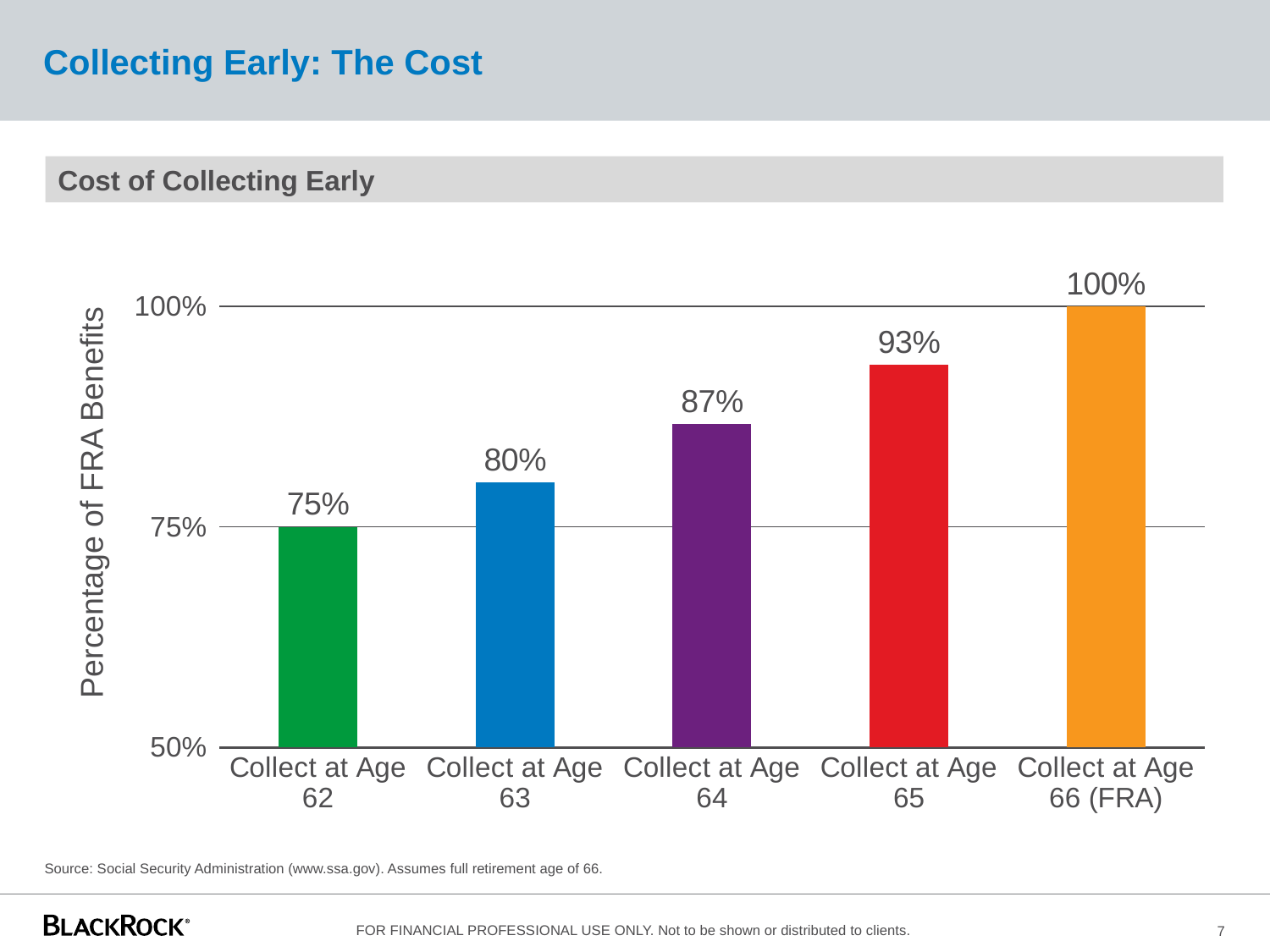
Which category has the highest percentage of FRA benefits? Collect at Age 66 (FRA) What percentage of FRA benefits is shown for Collect at Age 64? 87% What is the difference in percentage of FRA benefits between Collect at Age 64 and Collect at Age 63? 7% Which is larger, the value for Collect at Age 63 or the value for Collect at Age 65? Collect at Age 65 Do the values rise or fall as the collection age increases along the x axis? Rise What is the label of the vertical axis of the chart? Percentage of FRA Benefits Which category has the lowest percentage of FRA benefits? Collect at Age 62 What percentage of FRA benefits is shown for Collect at Age 65? 93% What is the difference in percentage of FRA benefits between Collect at Age 66 (FRA) and Collect at Age 62? 25% What percentage of FRA benefits is shown for Collect at Age 62? 75% What kind of chart is shown on the slide? Bar chart How many categories are shown in the chart? 5